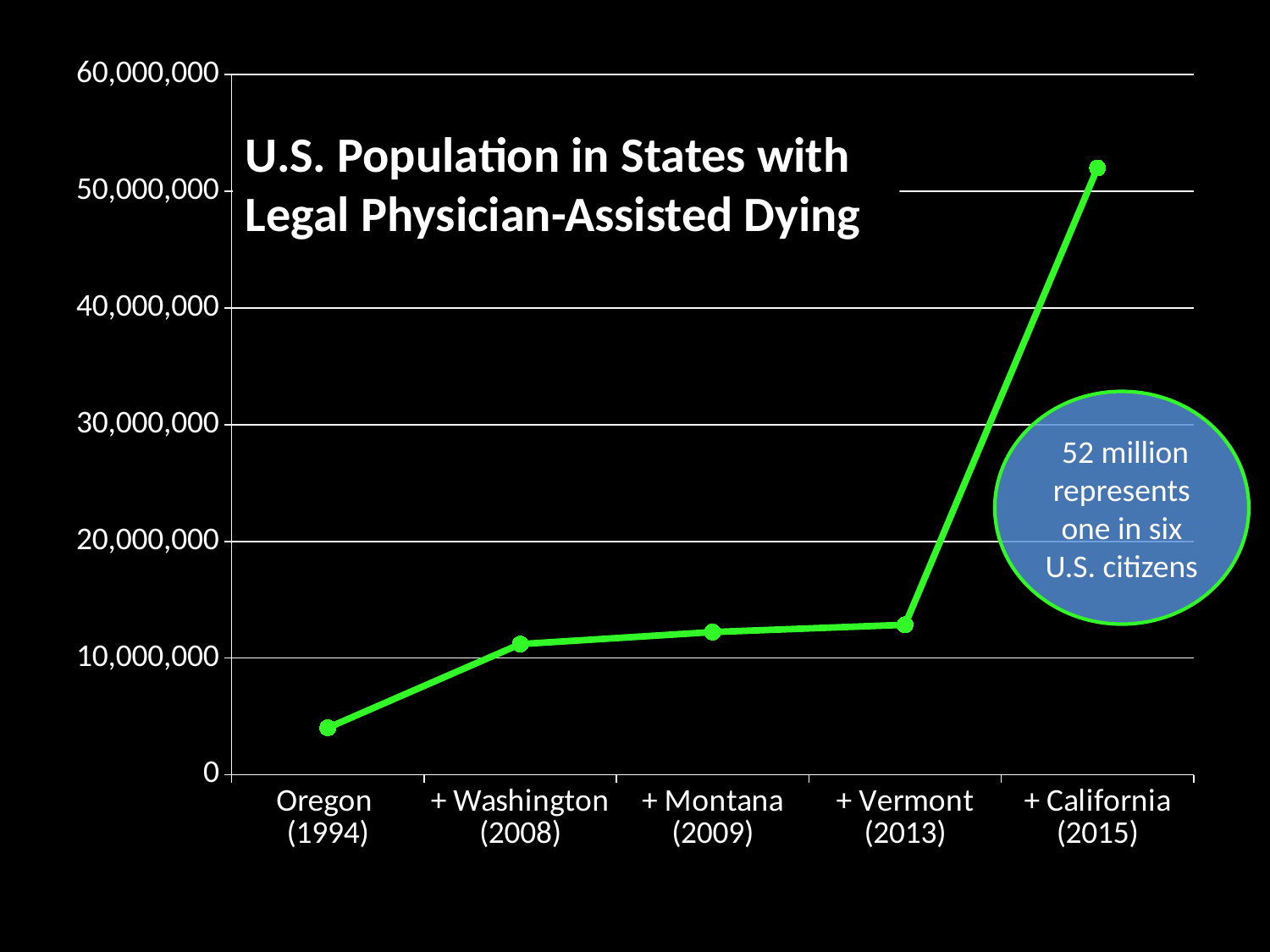
Which is larger, the value for Oregon (1994) or the value for + California (2015)? + California (2015) How many data points are plotted on the line? 5 Is the value for Oregon (1994) greater or less than 10,000,000? less What is the title of the chart? U.S. Population in States with Legal Physician-Assisted Dying Is the value for + Vermont (2013) greater or less than 20,000,000? less What kind of chart is shown on the slide? line chart Which category has the lowest value? Oregon (1994) Is the value for + Washington (2008) greater or less than 10,000,000? greater Do the values rise or fall from left to right along the x axis? rise Which category has the highest value? + California (2015) According to the callout on the chart, what does 52 million represent? one in six U.S. citizens